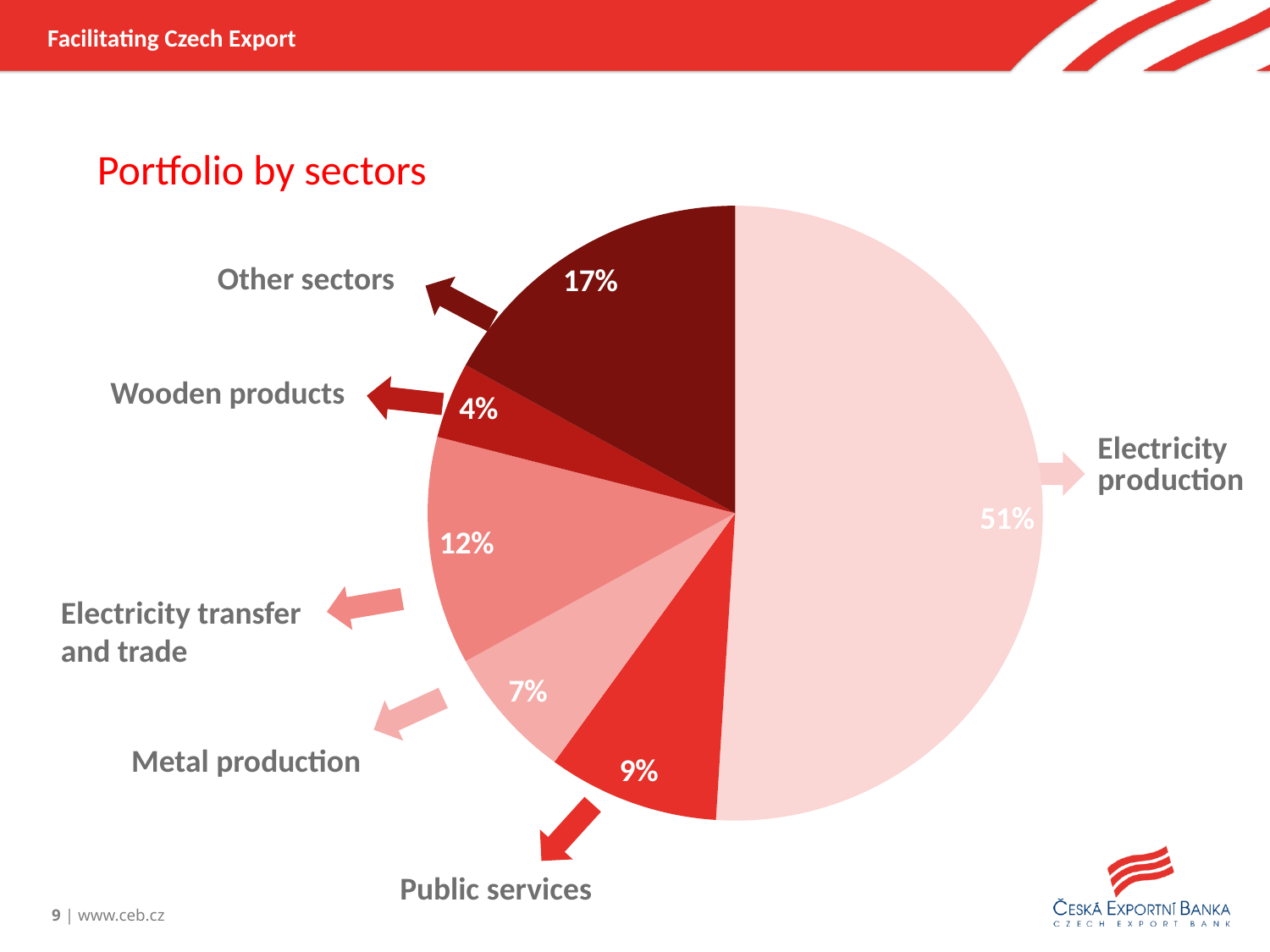
What type of chart is used to show the portfolio by sectors? Pie chart Which sector has the smallest share of the portfolio? Wooden products How many sectors are shown in the pie chart? 6 What percentage is shown for Public services? 9% What is the difference in percentage points between Other sectors and Metal production? 10 What percentage is shown for Wooden products? 4% What share of the portfolio does Electricity production account for? 51% Which has a larger share, Public services or Metal production? Public services What is the title of the chart? Portfolio by sectors Which sector has the largest share of the portfolio? Electricity production What percentage is shown for Electricity transfer and trade? 12% What percentage is shown for Other sectors? 17%